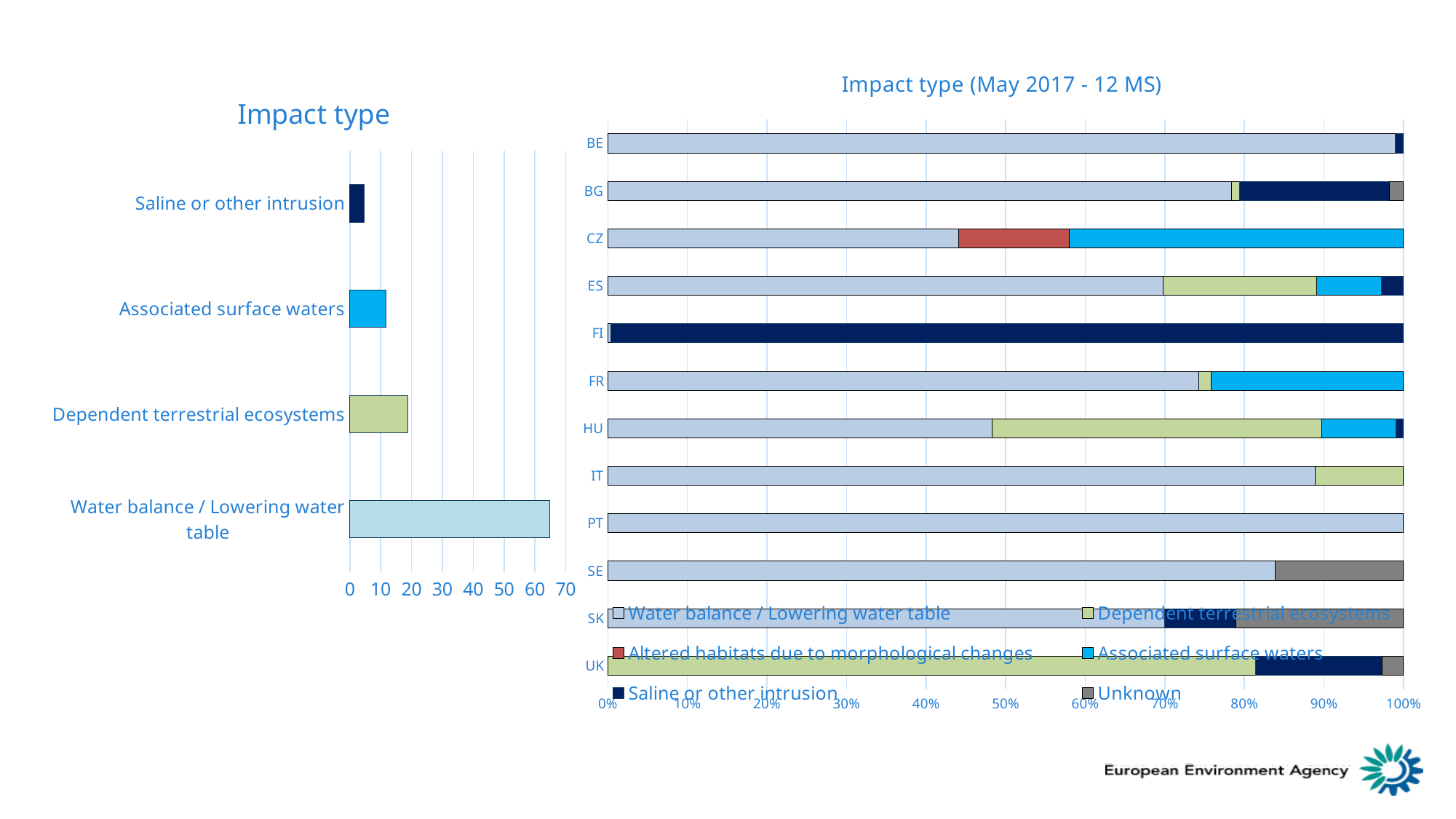
In the left chart "Impact type", is the value for Saline or other intrusion greater or less than 10? less In the left chart "Impact type", which category has the highest value? Water balance / Lowering water table In the right chart "Impact type (May 2017 - 12 MS)", is the Water balance / Lowering water table share for BE greater or less than 90%? greater In the right chart "Impact type (May 2017 - 12 MS)", which country is the only one with an Altered habitats due to morphological changes segment? CZ In the left chart "Impact type", which is larger: Dependent terrestrial ecosystems or Associated surface waters? Dependent terrestrial ecosystems In the right chart "Impact type (May 2017 - 12 MS)", how many series does the legend list? 6 In the right chart "Impact type (May 2017 - 12 MS)", which country's bar is made up entirely of Saline or other intrusion? FI In the left chart "Impact type", is the value for Water balance / Lowering water table greater or less than 60? greater In the left chart "Impact type", how many categories are shown? 4 In the right chart "Impact type (May 2017 - 12 MS)", how many countries are listed on the vertical axis? 12 In the left chart "Impact type", which category has the lowest value? Saline or other intrusion What type of chart is the left chart titled "Impact type"? bar chart